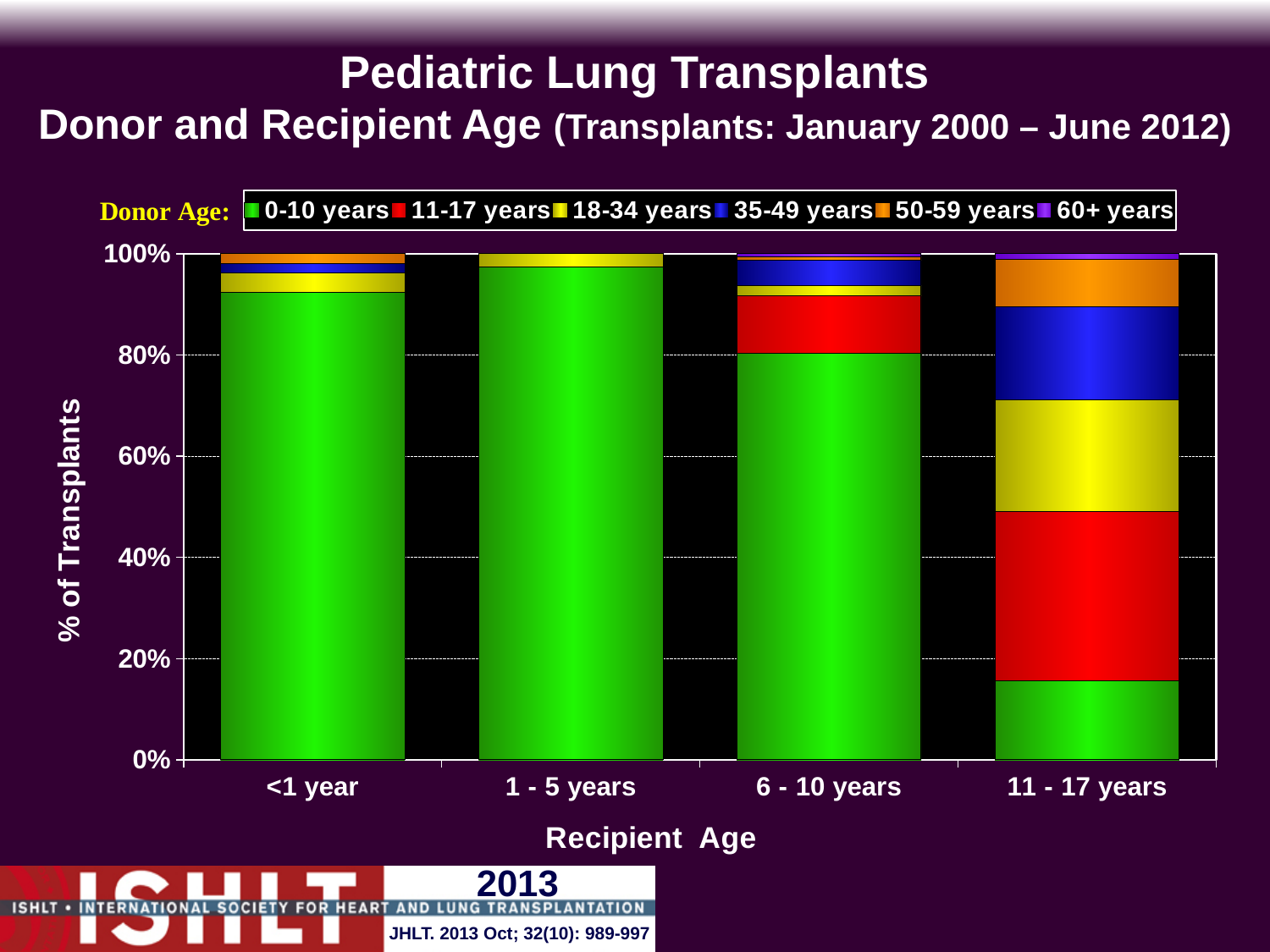
Which donor age group is shown in green in the legend? 0-10 years Is the share of 0-10 years donors for recipients aged <1 year greater or less than 80%? greater Is the share of 11-17 years donors for recipients aged 11 - 17 years greater or less than 20%? greater How many donor age groups does the legend list? 6 Is the share of 0-10 years donors for recipients aged 6 - 10 years greater or less than 60%? greater Which recipient age group has a larger share of 0-10 years donors, <1 year or 11 - 17 years? <1 year Which recipient age group has the smallest share of 0-10 years donors? 11 - 17 years What kind of chart is shown on the slide? Stacked bar chart Which recipient age group has the largest share of 0-10 years donors? 1 - 5 years How many recipient age categories are shown on the x axis? 4 What is the label of the y axis? % of Transplants